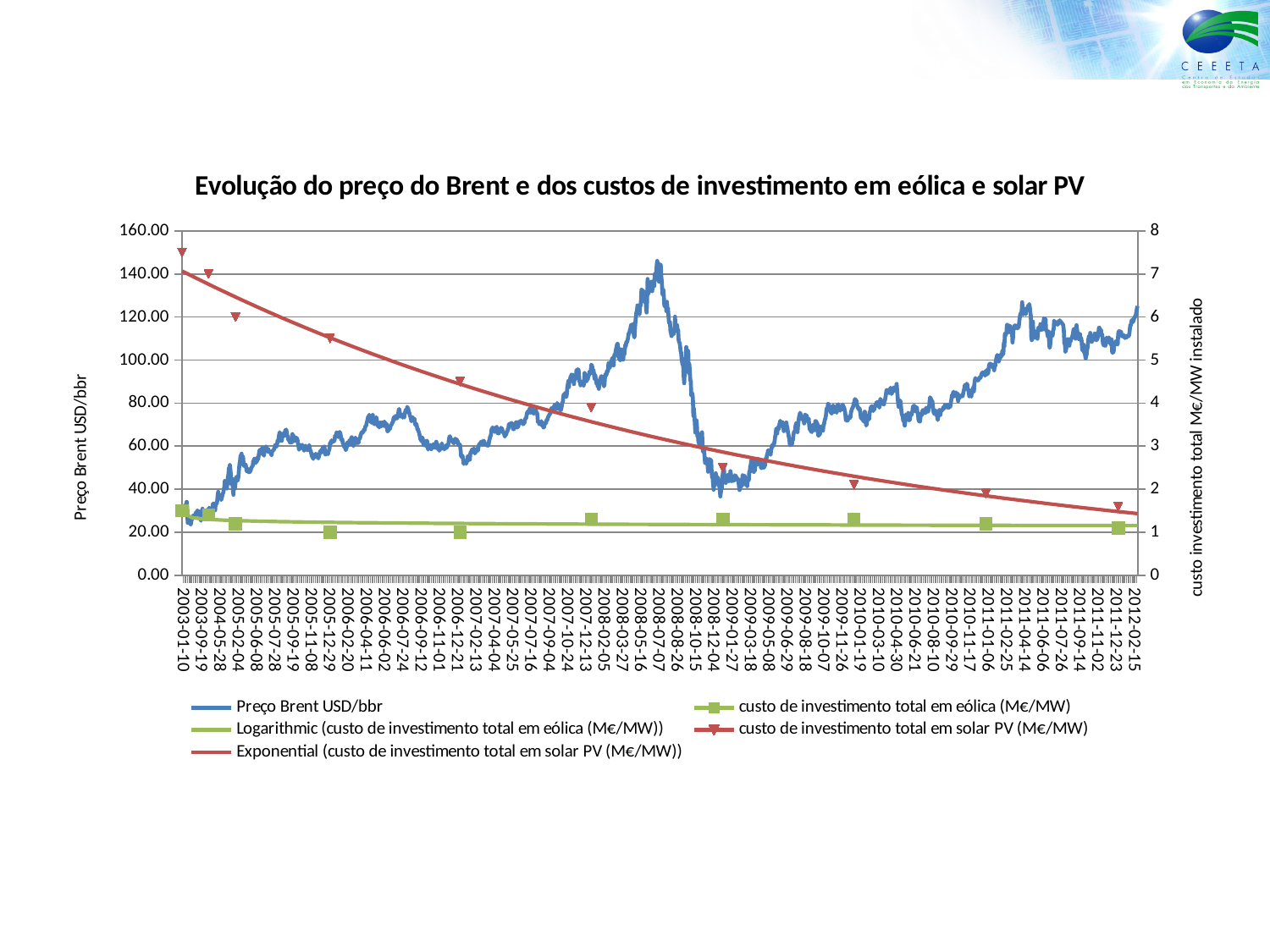
Which is larger: the Preço Brent USD/bbr value around 2008-07-07 or around 2009-01-27? around 2008-07-07 Is the first value of the custo de investimento total em solar PV (M€/MW) series, read on the right axis, greater or less than 7? greater Does the custo de investimento total em solar PV (M€/MW) series rise or fall over time along the x axis? fall Which colour is used for the Preço Brent USD/bbr series? blue Which is larger: the custo de investimento total em solar PV (M€/MW) value at the start of the period or at the end of the period? at the start of the period In which year does the Preço Brent USD/bbr series reach its highest value? 2008 What kind of chart is shown on the slide? line chart How many series does the legend list? 5 Is the last value of the custo de investimento total em solar PV (M€/MW) series, read on the right axis, greater or less than 2? less What is the title of the chart? Evolução do preço do Brent e dos custos de investimento em eólica e solar PV Is the highest value of the Preço Brent USD/bbr series greater or less than 140? greater